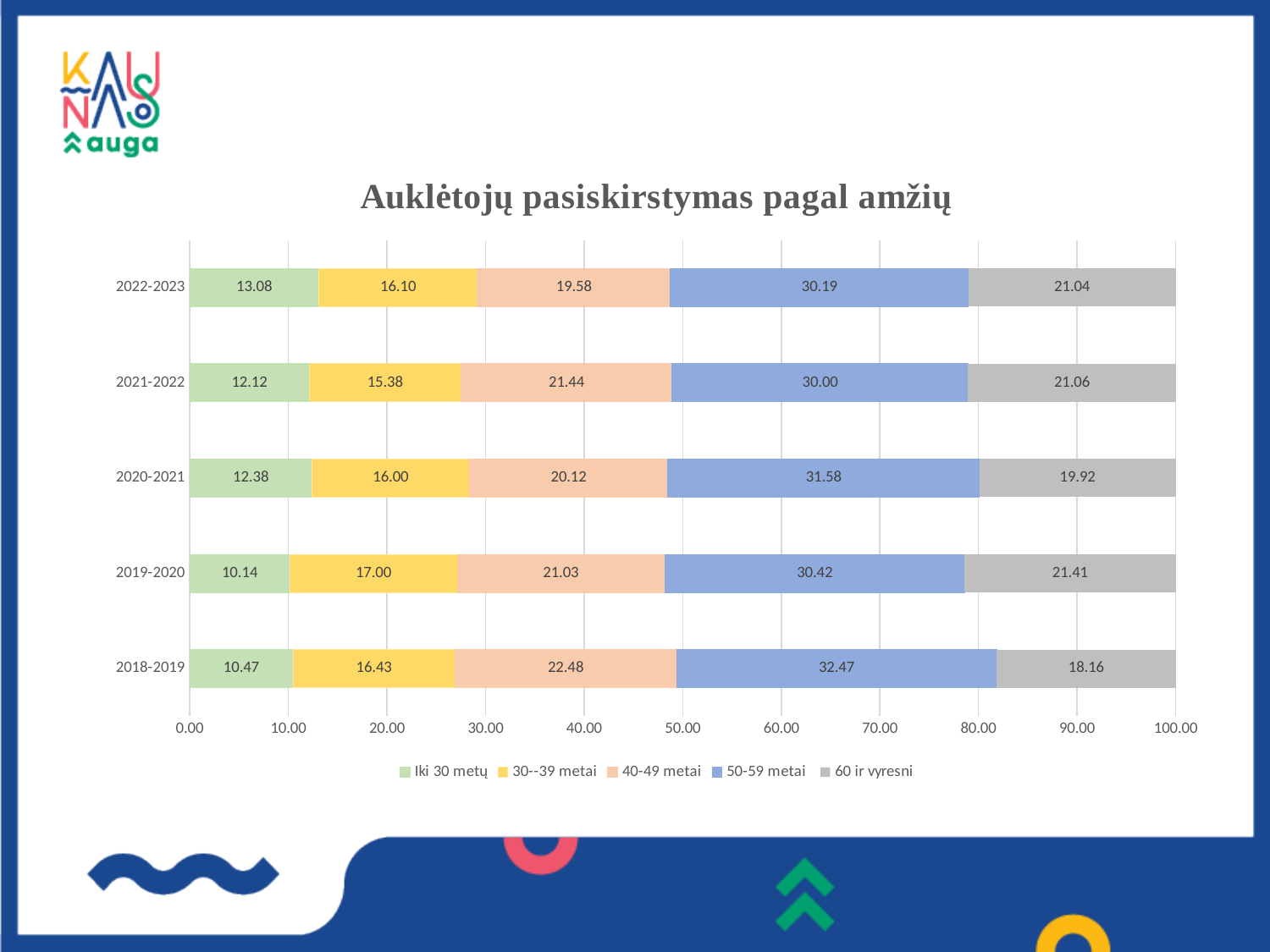
Which year has the highest value for "Iki 30 metų"? 2022-2023 What is the value for "40-49 metai" in 2021-2022? 21.44 What kind of chart is shown on the slide? Stacked bar chart What is the value for "Iki 30 metų" in 2022-2023? 13.08 What is the difference between the "50-59 metai" values for 2018-2019 and 2021-2022? 2.47 How many series does the legend list? 5 What is the title of the chart? Auklėtojų pasiskirstymas pagal amžių What is the value for "60 ir vyresni" in 2020-2021? 19.92 Which year has the lowest value for "60 ir vyresni"? 2018-2019 Which is larger: the "30--39 metai" value for 2019-2020 or for 2021-2022? 2019-2020 What is the value for "50-59 metai" in 2018-2019? 32.47 How many years (categories) are shown on the chart? 5